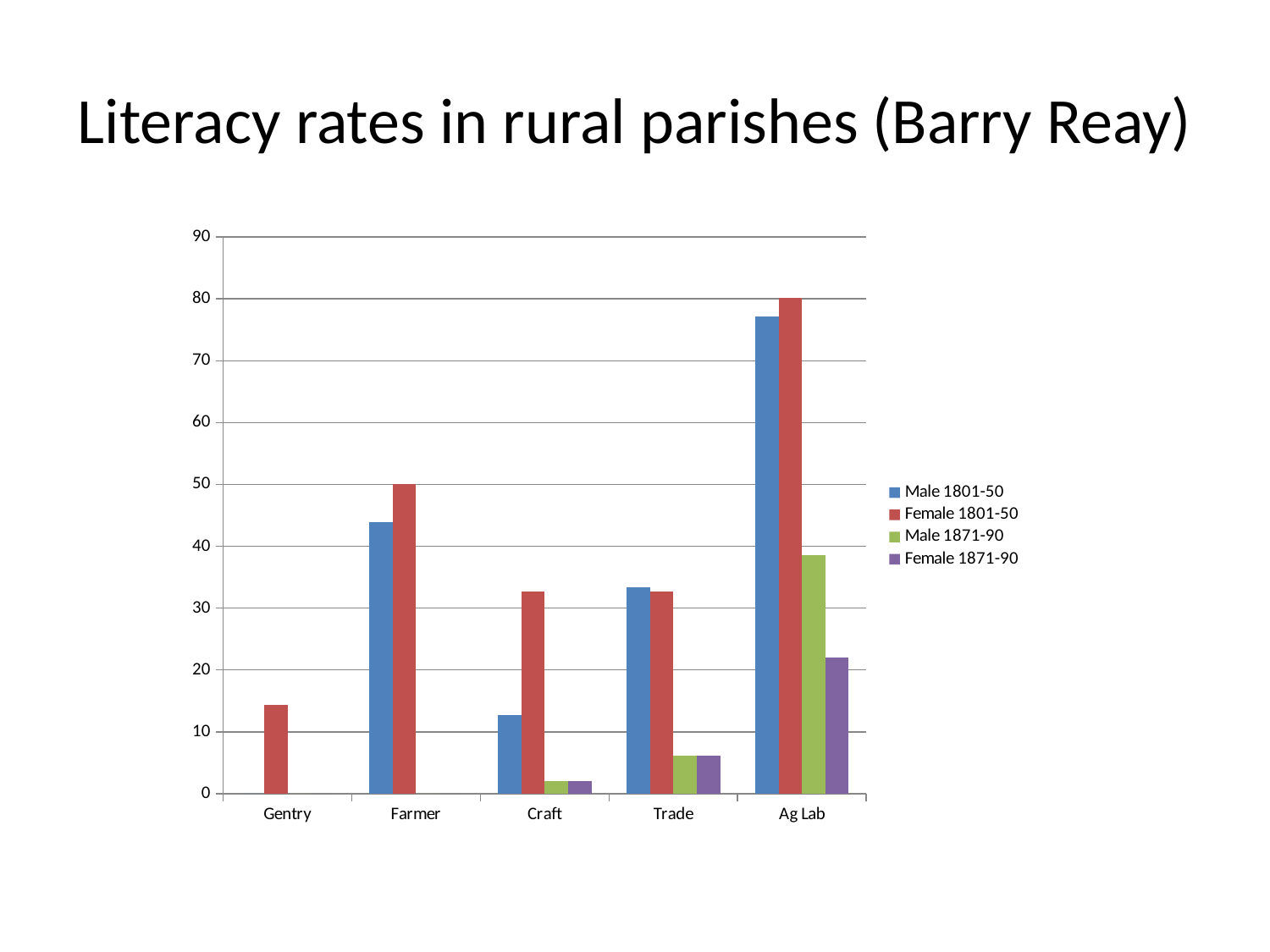
What is the title of the slide? Literacy rates in rural parishes (Barry Reay) Is the value for Male 1801-50 in Craft greater or less than 10? greater Is the value for Male 1801-50 in Ag Lab greater or less than 70? greater What kind of chart is shown on the slide? bar chart How many series does the legend list? 4 For Ag Lab, which is larger: Male 1871-90 or Female 1871-90? Male 1871-90 Is the value for Female 1801-50 in Gentry greater or less than 20? less Which category has the highest value for Male 1871-90? Ag Lab Which category has the highest value for Female 1801-50? Ag Lab How many occupational categories are shown on the x axis? 5 For Farmer, which is larger: Male 1801-50 or Female 1801-50? Female 1801-50